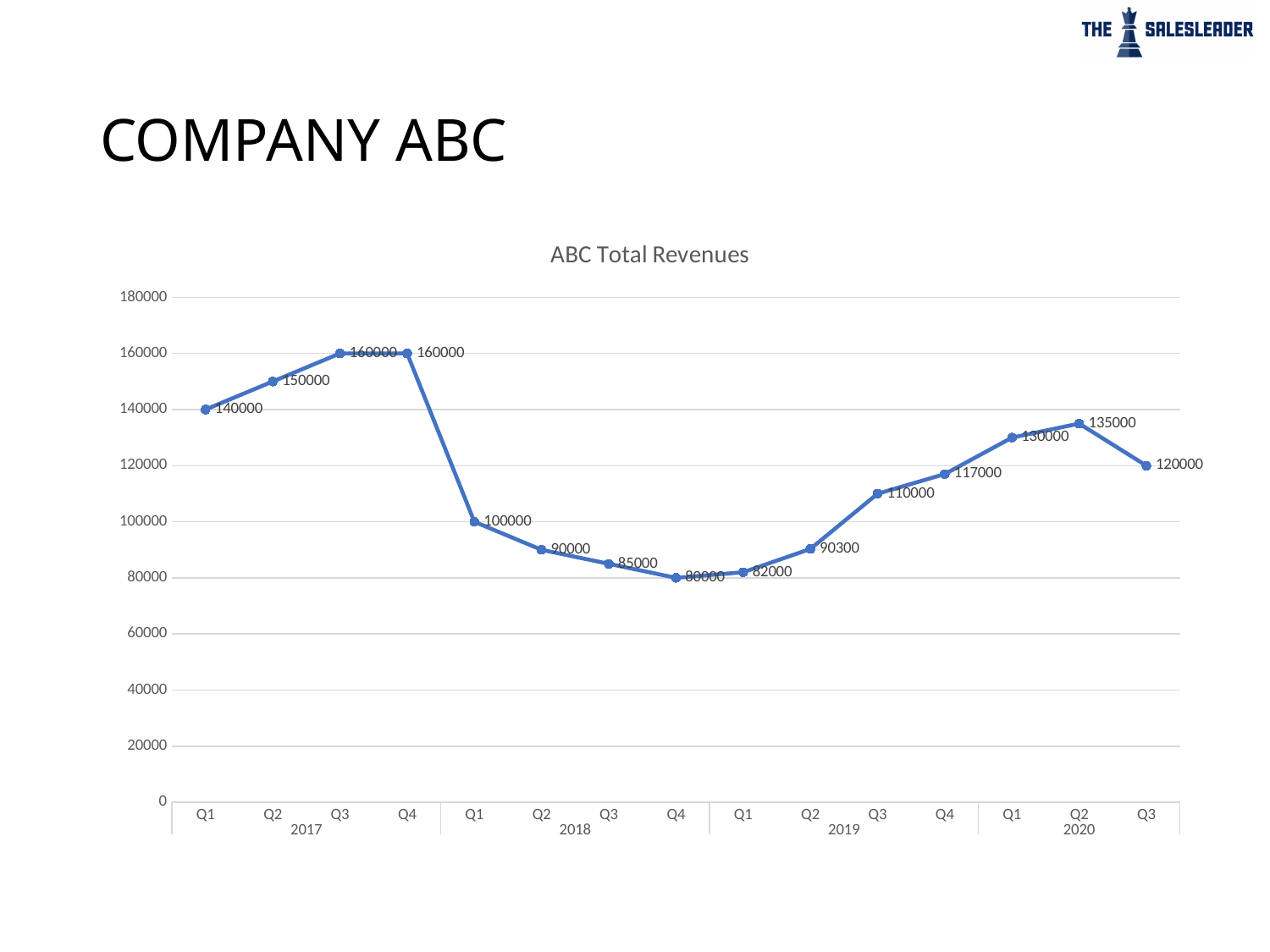
Which is larger, the value for Q2 2017 or the value for Q2 2020? Q2 2017 What is the title of the chart? ABC Total Revenues What is the value for Q4 2018? 80000 What is the value for Q2 2019? 90300 What is the difference between the values for Q4 2017 and Q1 2018? 60000 What is the value for Q1 2017? 140000 Is the value for Q4 2019 greater or less than 100000? greater Do the values rise or fall from Q1 2018 to Q4 2018? fall How many data points are plotted on the chart? 15 Which quarter has the lowest value? Q4 2018 What is the value for Q3 2020? 120000 What kind of chart is shown? line chart